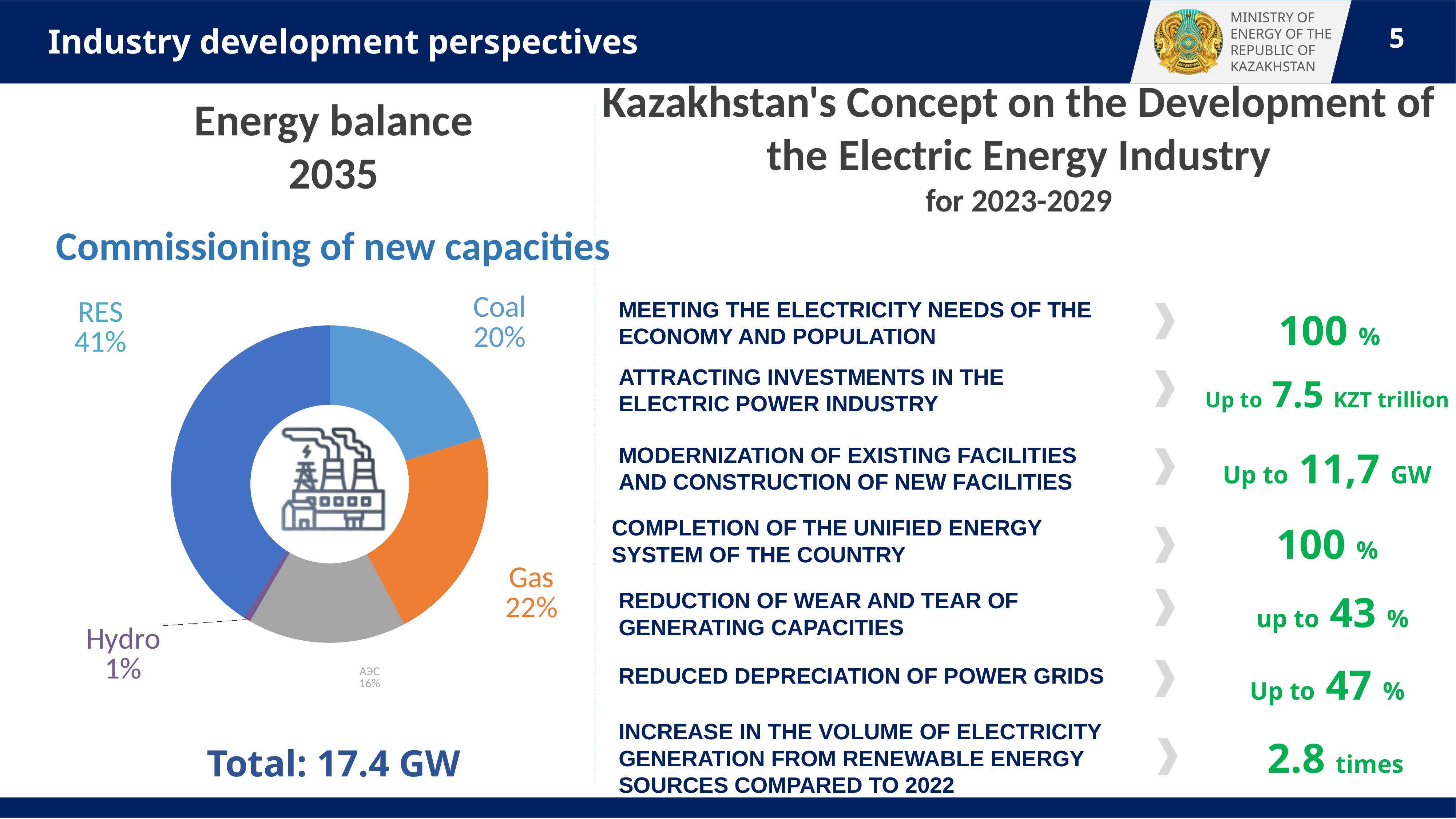
How many categories are shown in the commissioning of new capacities chart? 5 In the commissioning of new capacities chart, which is larger: Gas or Coal? Gas What share of the commissioning of new capacities is АЭС? 16% What is the difference in percentage points between the Gas and Coal shares in the commissioning of new capacities chart? 2 percentage points What kind of chart is shown under "Commissioning of new capacities"? Pie (donut) chart What share of the commissioning of new capacities is Hydro? 1% What share of the commissioning of new capacities is RES? 41% What share of the commissioning of new capacities is Coal? 20% What total capacity is stated below the commissioning of new capacities chart? 17.4 GW Which category has the smallest share in the commissioning of new capacities chart? Hydro What share of the commissioning of new capacities is Gas? 22% Which category has the largest share in the commissioning of new capacities chart? RES